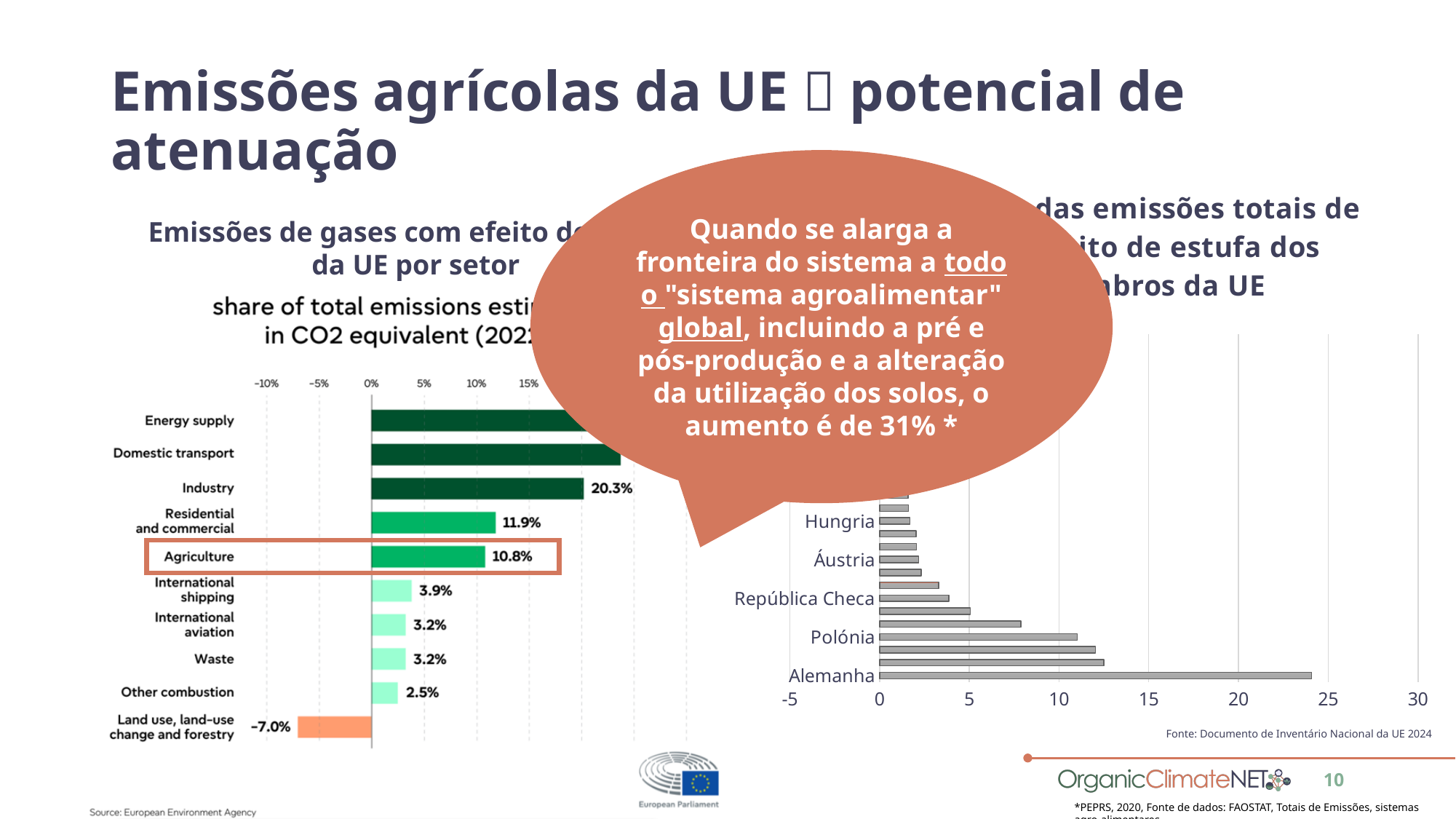
In the left chart (Emissões de gases com efeito de estufa da UE por setor), which sector has the lowest value? Land use, land-use change and forestry In the left chart (Emissões de gases com efeito de estufa da UE por setor), what is the difference between International shipping and Waste? 0.7% In the left chart (Emissões de gases com efeito de estufa da UE por setor), which sector is highlighted with an orange box? Agriculture In the right chart of EU member states, is the value for Alemanha greater or less than 20? greater In the left chart (Emissões de gases com efeito de estufa da UE por setor), what is the value for Residential and commercial? 11.9% In the left chart (Emissões de gases com efeito de estufa da UE por setor), what is the difference between the values for Industry and Agriculture? 9.5% In the left chart (Emissões de gases com efeito de estufa da UE por setor), which is larger, Residential and commercial or Agriculture? Residential and commercial In the left chart (Emissões de gases com efeito de estufa da UE por setor), what is the value for Agriculture? 10.8% In the left chart (Emissões de gases com efeito de estufa da UE por setor), what is the value for Land use, land-use change and forestry? -7.0% In the left chart (Emissões de gases com efeito de estufa da UE por setor), how many sectors are plotted? 10 In the left chart (Emissões de gases com efeito de estufa da UE por setor), what is the value for Industry? 20.3% What kind of chart is the left chart (Emissões de gases com efeito de estufa da UE por setor)? Bar chart